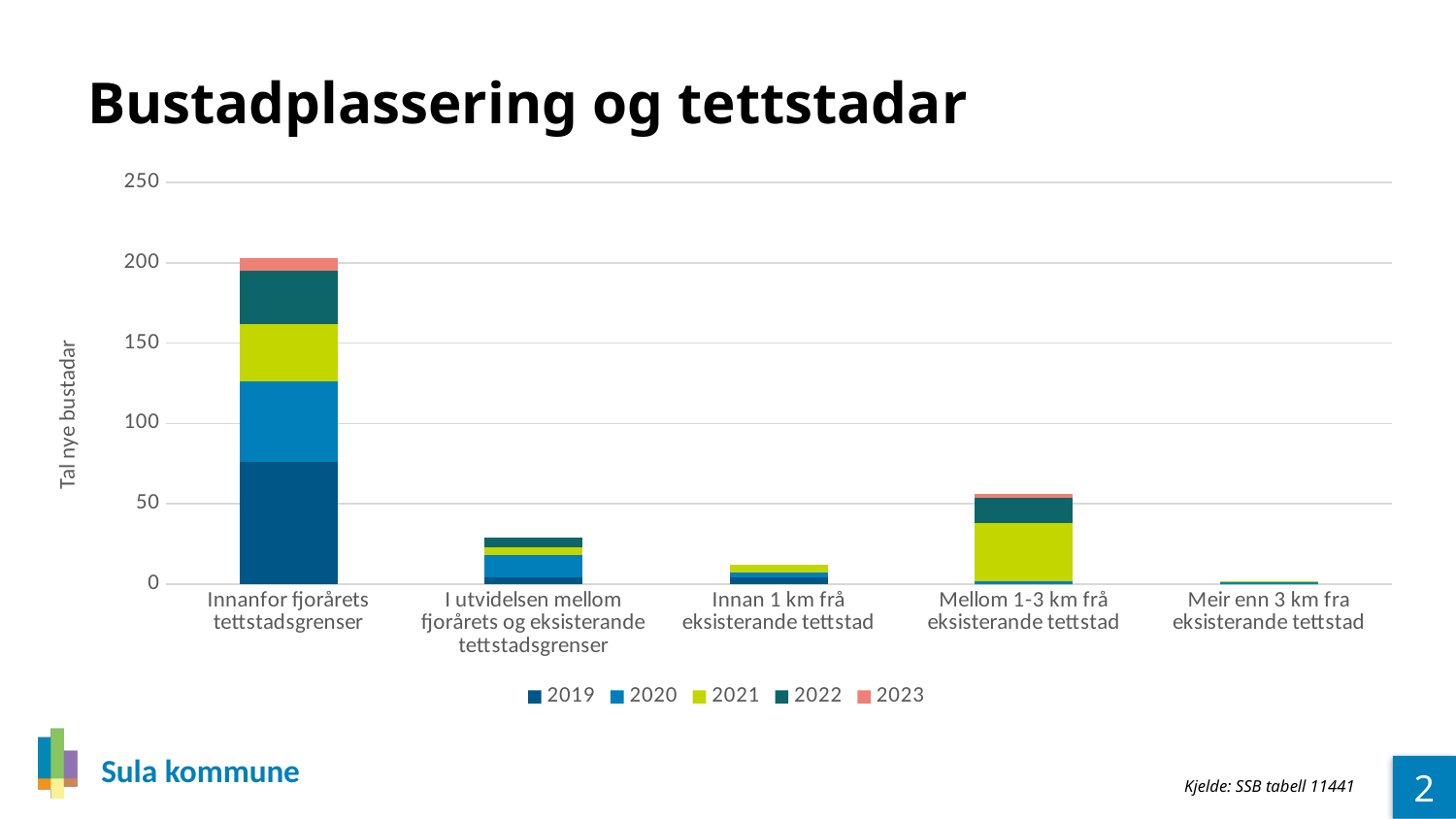
What is the title of the chart on the slide? Bustadplassering og tettstadar Which has the larger total stacked bar: Mellom 1-3 km frå eksisterande tettstad or I utvidelsen mellom fjorårets og eksisterande tettstadsgrenser? Mellom 1-3 km frå eksisterande tettstad Which category has the tallest stacked bar? Innanfor fjorårets tettstadsgrenser Is the total stacked value for I utvidelsen mellom fjorårets og eksisterande tettstadsgrenser greater or less than 50? less How many categories are shown on the x axis of the chart? 5 Is the total stacked value for Mellom 1-3 km frå eksisterande tettstad greater or less than 100? less How many series does the chart's legend list? 5 Is the total stacked value for Innan 1 km frå eksisterande tettstad greater or less than 50? less Which category has the shortest stacked bar? Meir enn 3 km fra eksisterande tettstad What is the label of the y axis? Tal nye bustadar What kind of chart is shown on the slide? Stacked bar chart